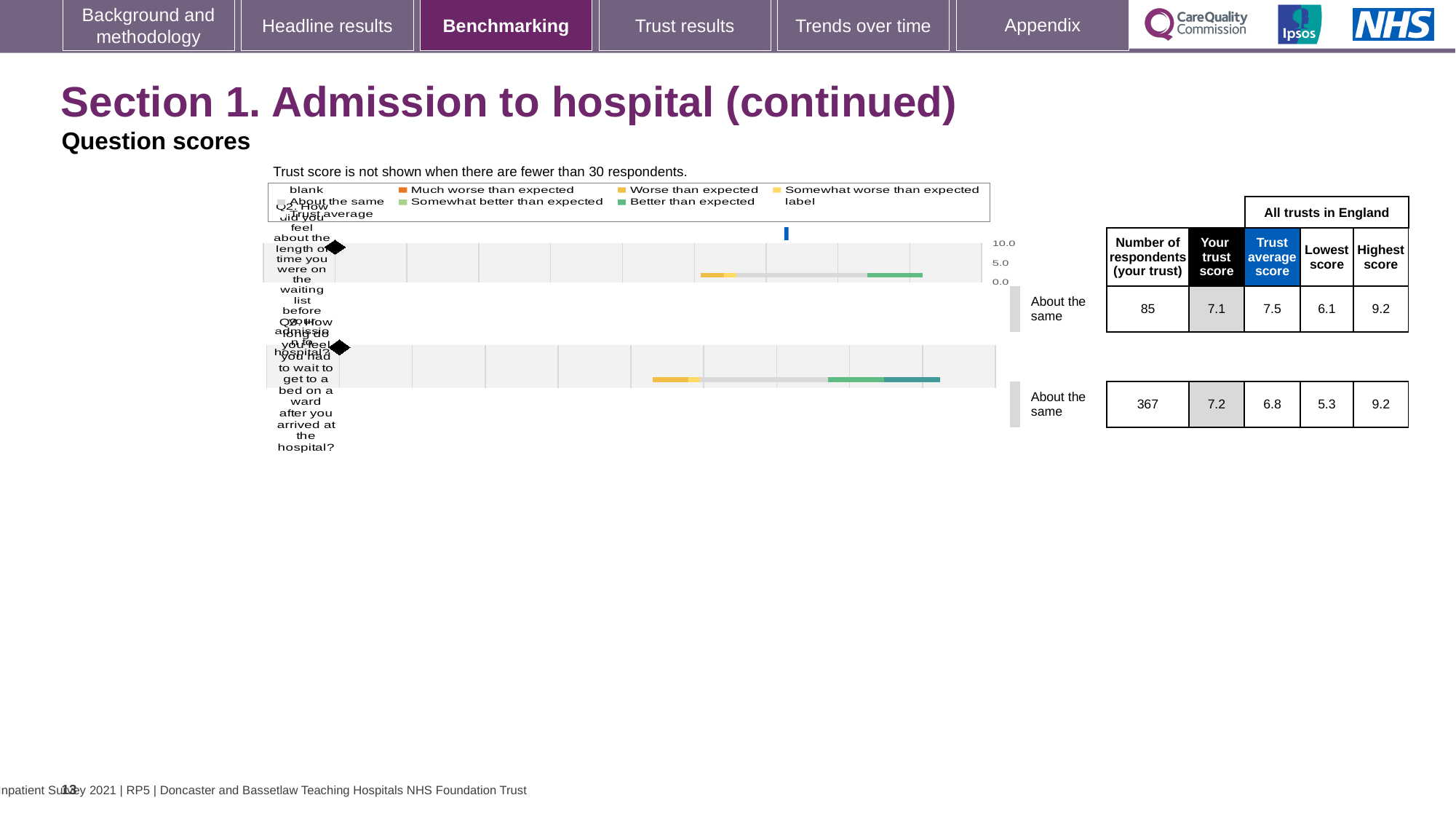
What benchmark category is the trust's score placed in for Q2? About the same For Q3 (wait to get to a bed on a ward after arriving), what is the trust score shown in the table? 7.2 How many respondents from the trust answered Q3? 367 Which question has the larger number of respondents, Q2 or Q3? Q3 For Q2, is the trust's score higher or lower than the trust average score? lower For Q3, what is the difference between the trust's score and the trust average score? 0.4 How many respondents from the trust answered Q2? 85 For Q2 (length of time on the waiting list before admission), what is the trust score shown in the table? 7.1 What is the highest score among all trusts in England for Q2? 9.2 What is the lowest score among all trusts in England for Q3? 5.3 What is the trust average score across all trusts in England for Q2? 7.5 What is the maximum value shown on the score axis of the charts? 10.0